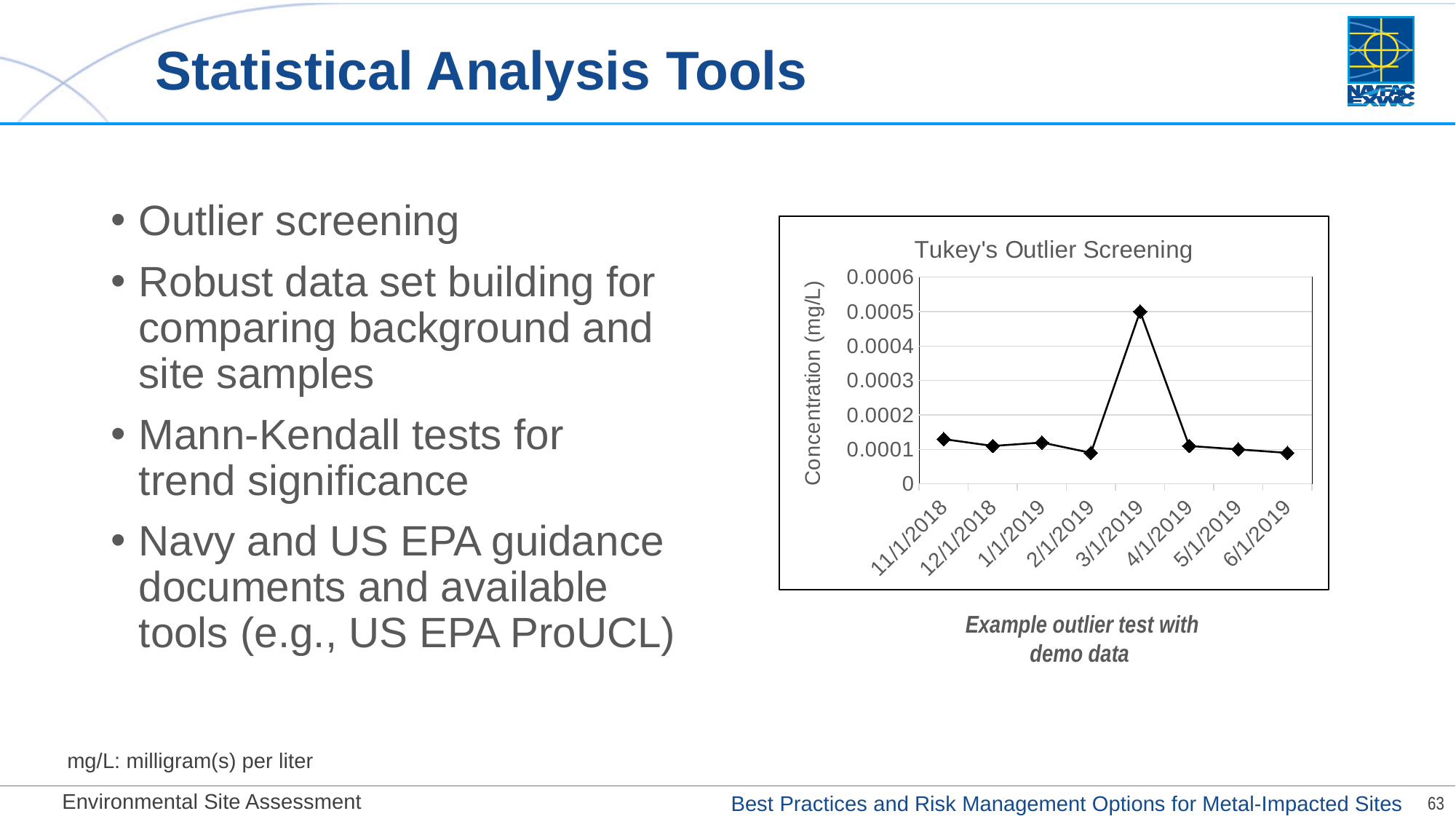
Which date has the highest concentration on the chart? 3/1/2019 Is the value for 3/1/2019 greater or less than 0.0004? greater Which has the larger concentration, 3/1/2019 or 4/1/2019? 3/1/2019 What is the label of the y axis of the chart? Concentration (mg/L) What is the title of the chart? Tukey's Outlier Screening Does the concentration rise or fall from 3/1/2019 to 4/1/2019? fall Which has the larger concentration, 2/1/2019 or 3/1/2019? 3/1/2019 What kind of chart is shown on the slide? line chart Is the value for 11/1/2018 greater or less than 0.0002? less What is the concentration plotted for 3/1/2019? 0.0005 How many data points are plotted on the chart? 8 Is the value for 6/1/2019 greater or less than 0.0002? less